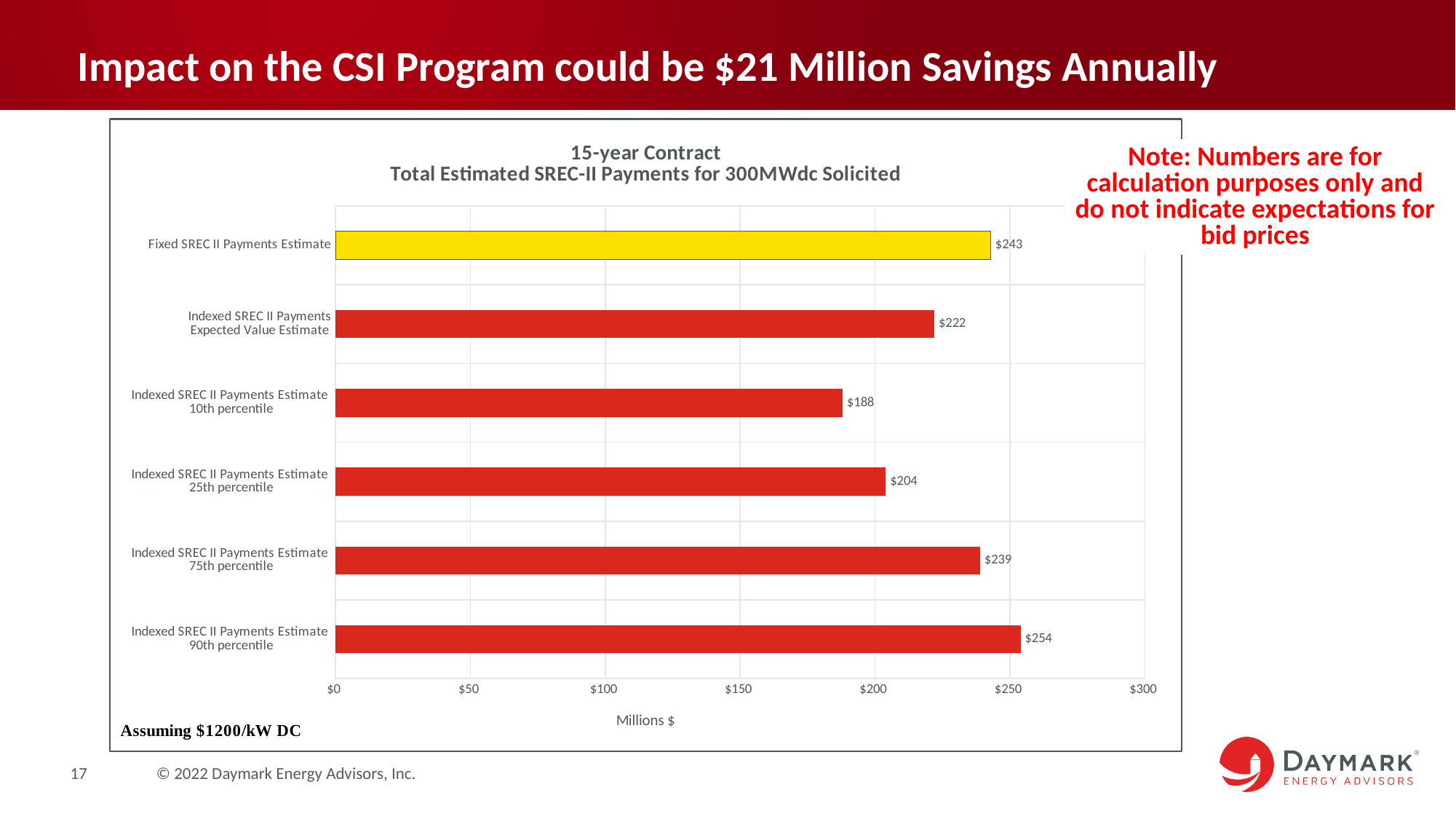
What is the value for Indexed SREC II Payments Expected Value Estimate? $222 What is the x-axis label of the chart? Millions $ What is the difference between the Fixed SREC II Payments Estimate and the Indexed SREC II Payments Expected Value Estimate? $21 What kind of chart is shown on the slide? bar chart What is the value for Indexed SREC II Payments Estimate 90th percentile? $254 What is the value for Fixed SREC II Payments Estimate? $243 What is the value for Indexed SREC II Payments Estimate 10th percentile? $188 Which is larger: the Indexed SREC II Payments Estimate 25th percentile or the Indexed SREC II Payments Estimate 75th percentile? Indexed SREC II Payments Estimate 75th percentile How many categories are shown in the chart? 6 Which category has the lowest value? Indexed SREC II Payments Estimate 10th percentile Which category has the highest value? Indexed SREC II Payments Estimate 90th percentile Is the value for Indexed SREC II Payments Estimate 25th percentile greater or less than $250? less